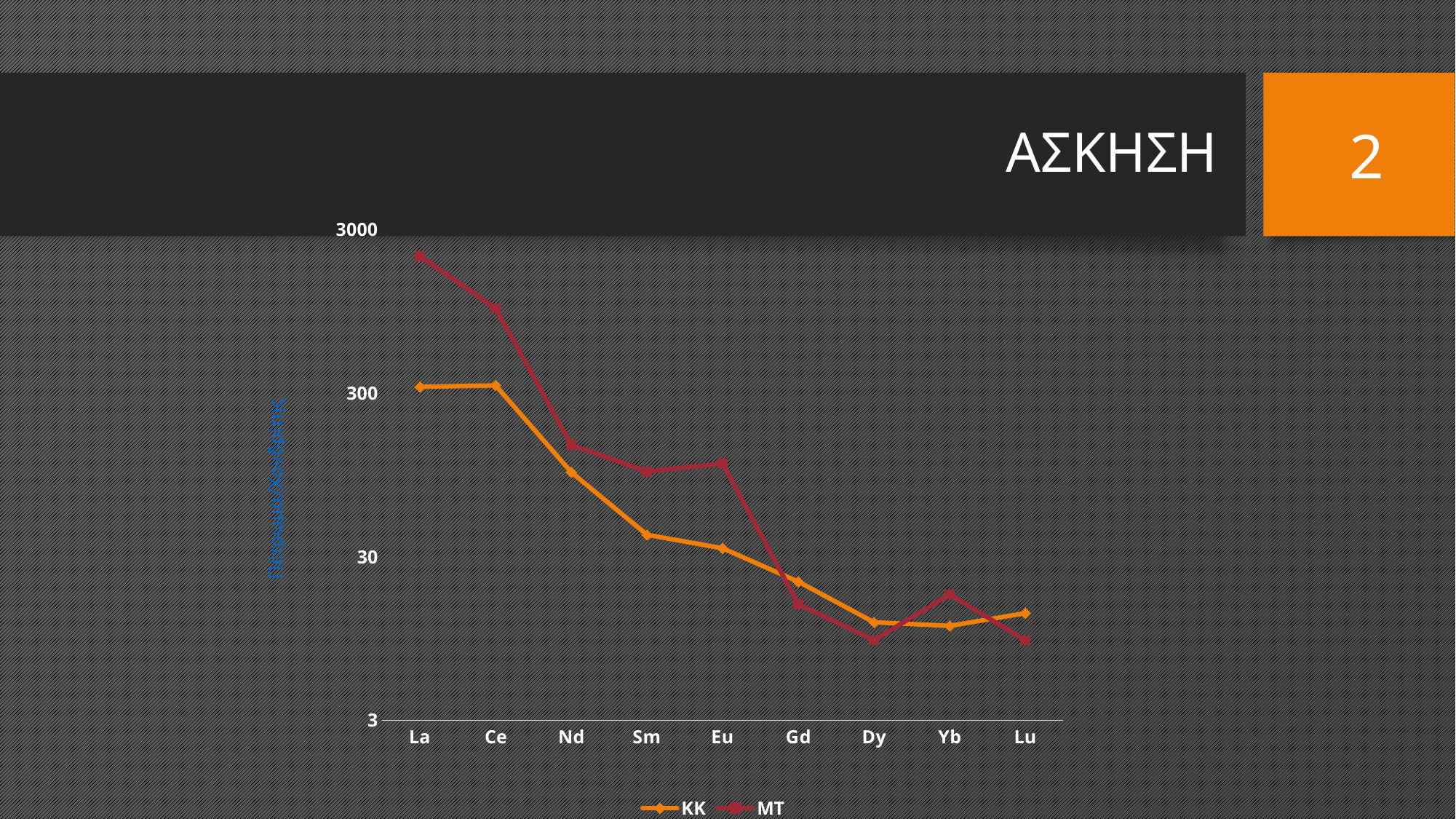
What kind of chart is shown on the slide? line chart Overall, do the values of the MT series rise or fall from La to Lu? fall How many series does the chart's legend list? 2 At Yb, which series has the larger value, KK or MT? MT At Lu, which series has the larger value, KK or MT? KK Is the value of KK at Sm greater or less than 300? less How many categories are shown on the x axis of the chart? 9 Which series has the highest value at La? MT Is the value of MT at La greater or less than 300? greater For which category does the MT series reach its highest value? La Is the value of MT at Dy greater or less than 30? less